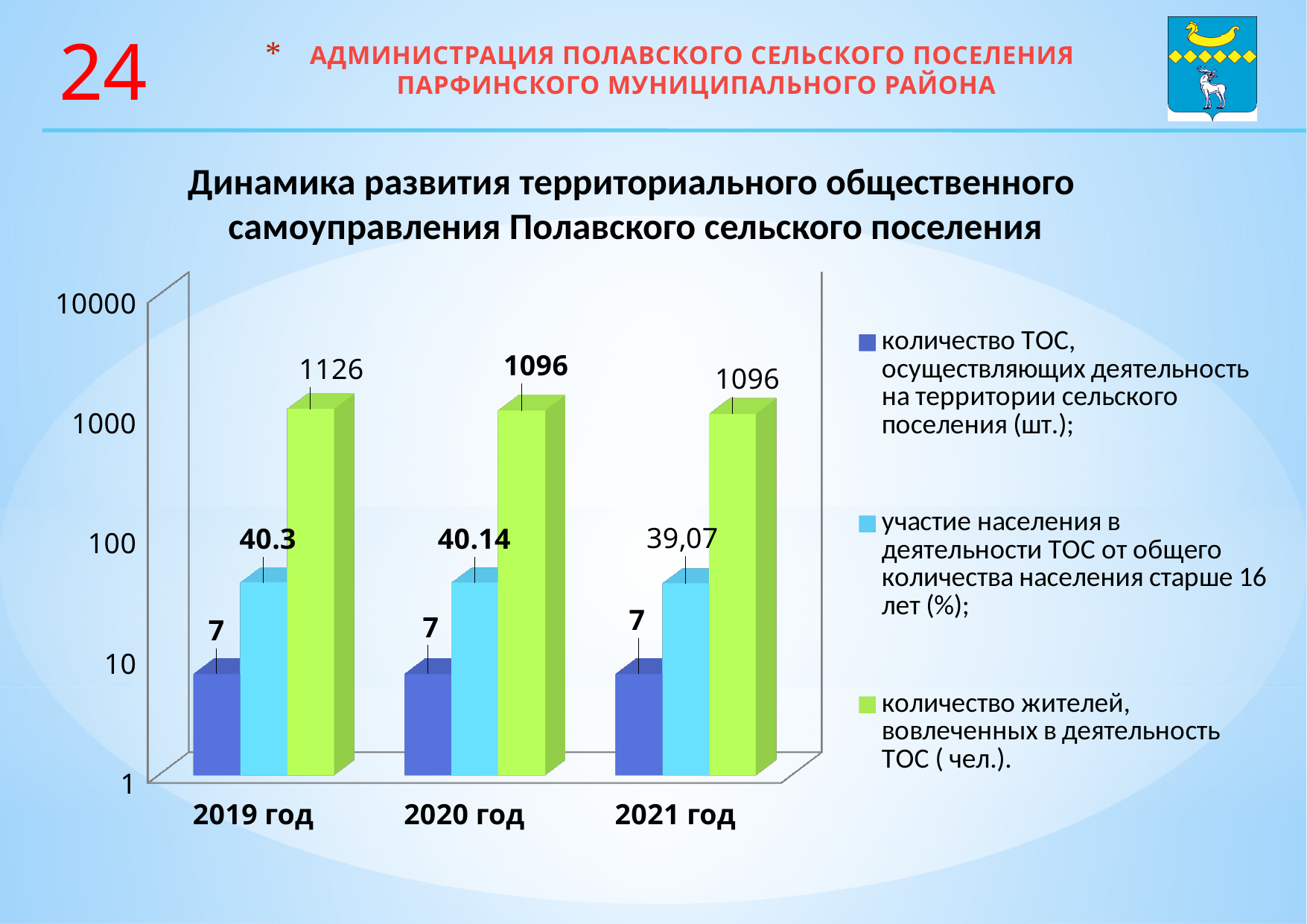
Does the number of residents involved in TOC activity rise or fall from 2019 год to 2021 год? fall What is the difference between the number of residents involved in TOC activity in 2019 год and in 2020 год? 30 What is the number of TOC operating in the settlement (количество ТОС) in 2020 год? 7 Which is larger: the population participation in TOC activity in 2019 год or in 2021 год? 2019 год What is the population participation in TOC activity (участие населения в деятельности ТОС) in 2020 год? 40.14 What is the number of residents involved in TOC activity (количество жителей, вовлеченных в деятельность ТОС) in 2019 год? 1126 What is the number of residents involved in TOC activity (количество жителей, вовлеченных в деятельность ТОС) in 2021 год? 1096 What is the population participation in TOC activity (участие населения в деятельности ТОС) in 2021 год? 39,07 What type of chart is shown on the slide? bar chart How many series does the legend list? 3 In which year is the number of residents involved in TOC activity the highest? 2019 год How many year categories are shown on the x axis? 3